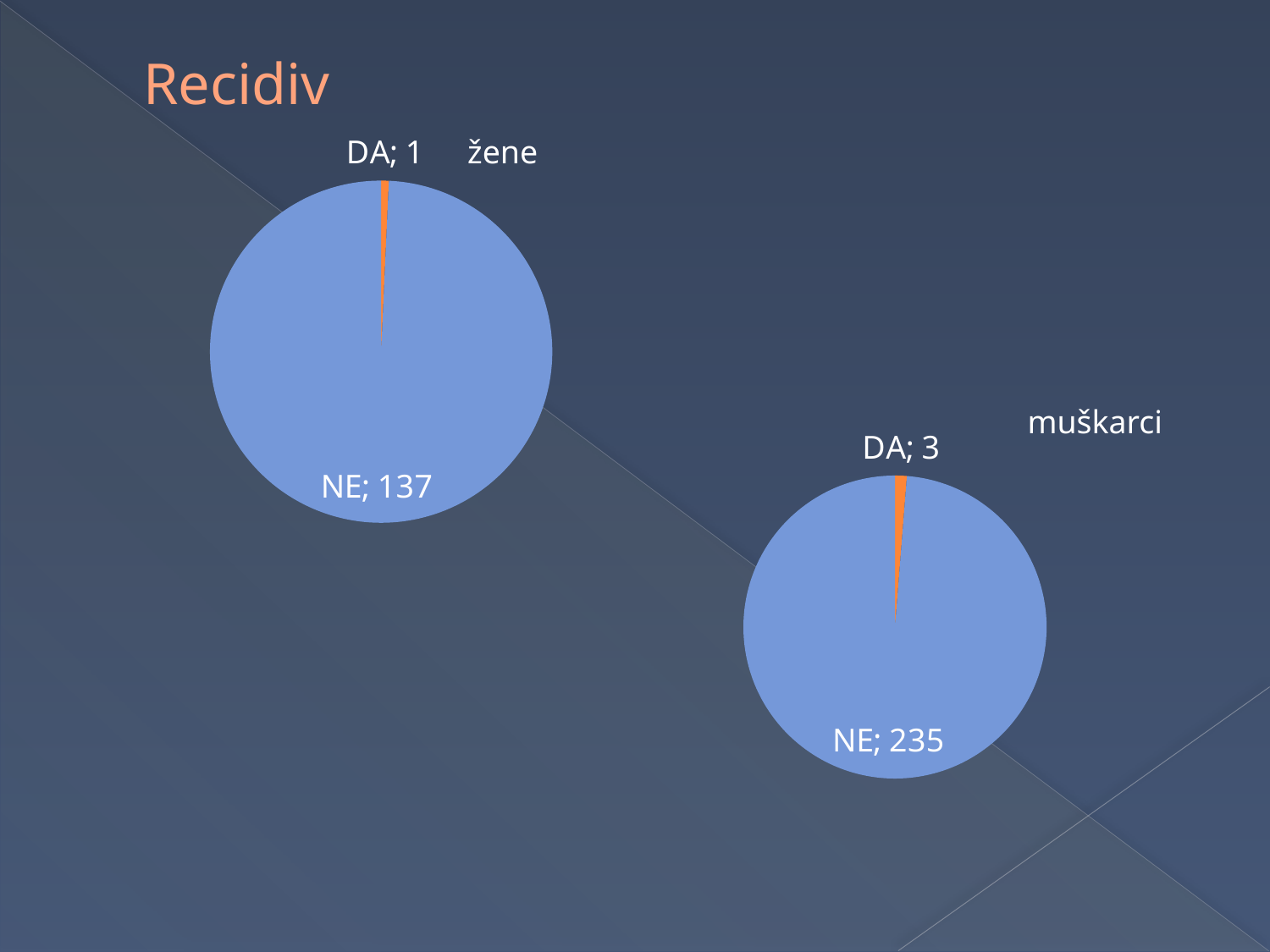
In the "žene" pie chart, what is the value for DA? 1 What is the total of the values shown in the "žene" pie chart? 138 Which is larger: the NE value in the "žene" chart or the NE value in the "muškarci" chart? muškarci In the "žene" pie chart, which category has the smallest slice? DA In the "muškarci" pie chart, what is the value for DA? 3 How many slices does the "muškarci" pie chart have? 2 What is the title of the slide containing the two pie charts? Recidiv In the "žene" pie chart, what is the value for NE? 137 In the "muškarci" pie chart, what is the difference between the NE and DA values? 232 In the "muškarci" pie chart, what is the value for NE? 235 In the "muškarci" pie chart, which category has the largest slice? NE What type of chart is used for "žene"? pie chart